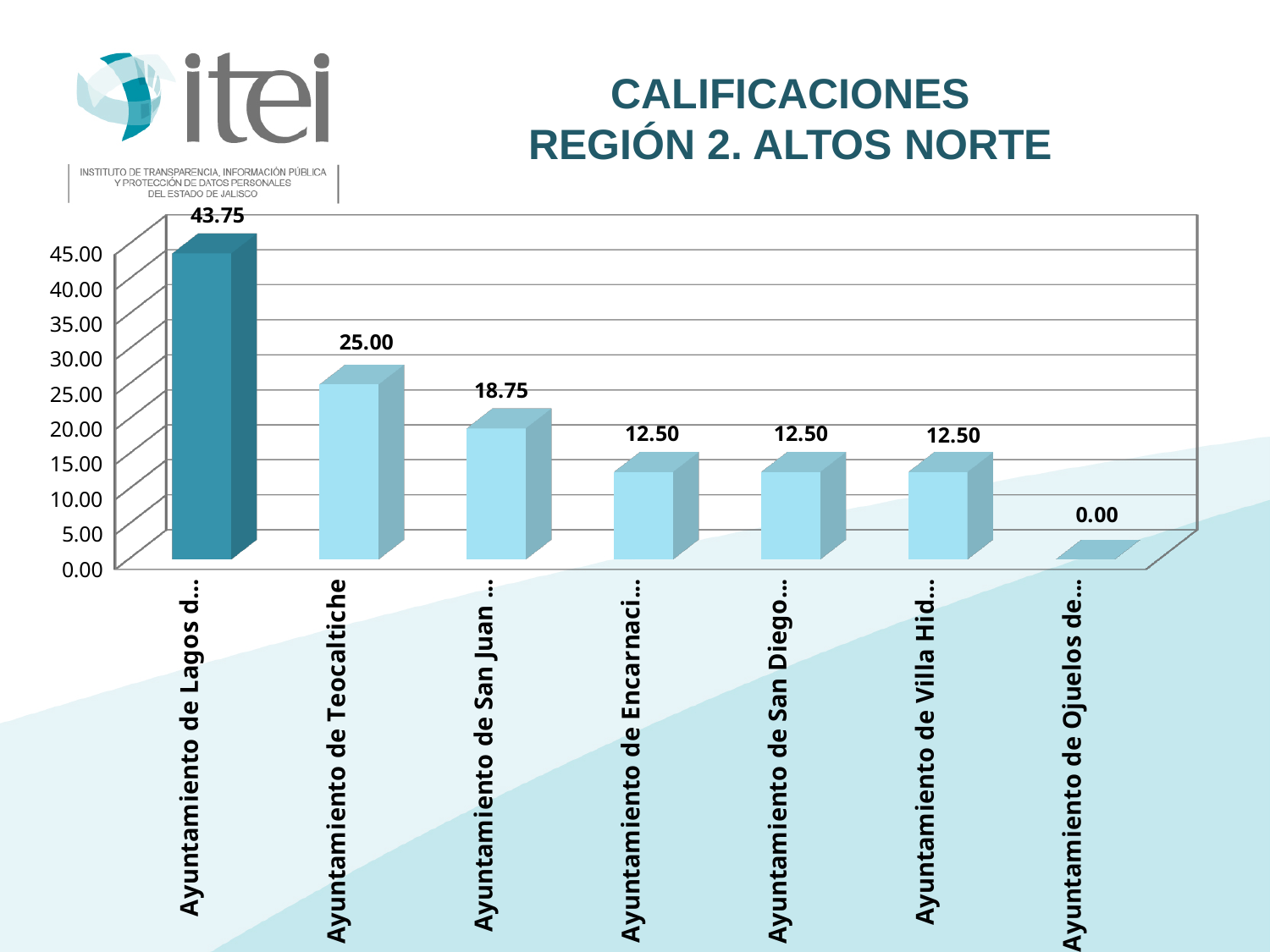
How many categories (bars) are shown in the chart? 7 What value is shown for Ayuntamiento de Teocaltiche? 25.00 Which is larger: the value for Ayuntamiento de Teocaltiche or the value for "Ayuntamiento de San Juan …"? Ayuntamiento de Teocaltiche Which category has the lowest value in the chart? Ayuntamiento de Ojuelos de… What is the difference between the value for "Ayuntamiento de Lagos d…" and the value for Ayuntamiento de Teocaltiche? 18.75 What is the title of the slide containing the chart? CALIFICACIONES REGIÓN 2. ALTOS NORTE What value is shown for the first bar, labelled "Ayuntamiento de Lagos d…"? 43.75 What value is shown for the last bar, labelled "Ayuntamiento de Ojuelos de…"? 0.00 What value is shown for the bar labelled "Ayuntamiento de San Juan …"? 18.75 Which category has the highest value in the chart? Ayuntamiento de Lagos d… What kind of chart is shown on the slide? Bar chart Do the values rise or fall from left to right across the chart? Fall